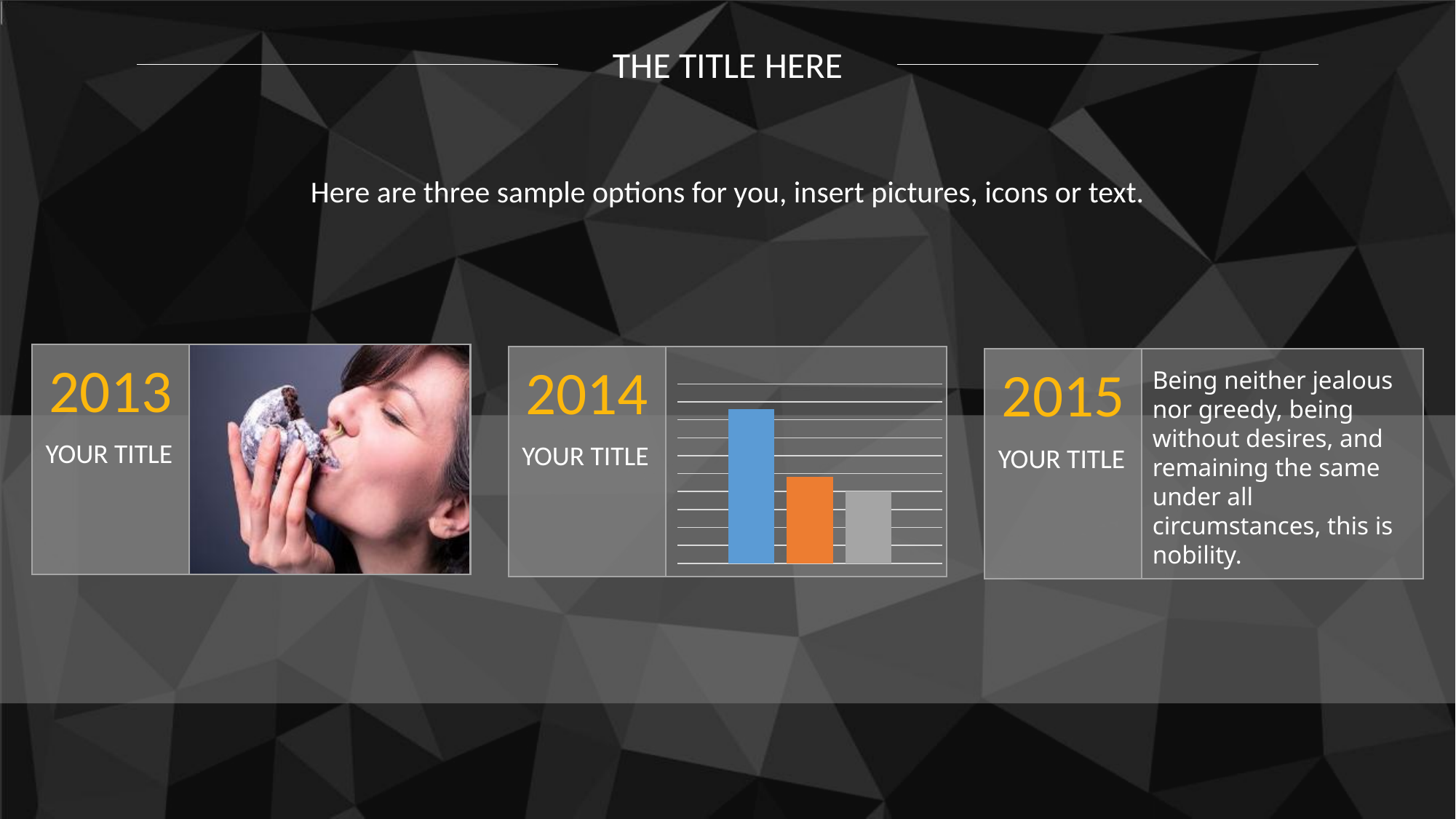
Does the chart in the 2014 panel show a legend? No What colour is the leftmost bar in the chart in the 2014 panel? blue Do the bar heights in the 2014 panel chart rise or fall from left to right? fall In the chart in the 2014 panel, which coloured bar is the tallest? the blue bar How many bars does the chart in the 2014 panel have? 3 In the chart in the 2014 panel, which coloured bar is the shortest? the gray bar In the chart in the 2014 panel, is the orange bar or the gray bar taller? the orange bar What kind of chart is shown in the 2014 panel? bar chart In the chart in the 2014 panel, is the blue bar or the orange bar taller? the blue bar